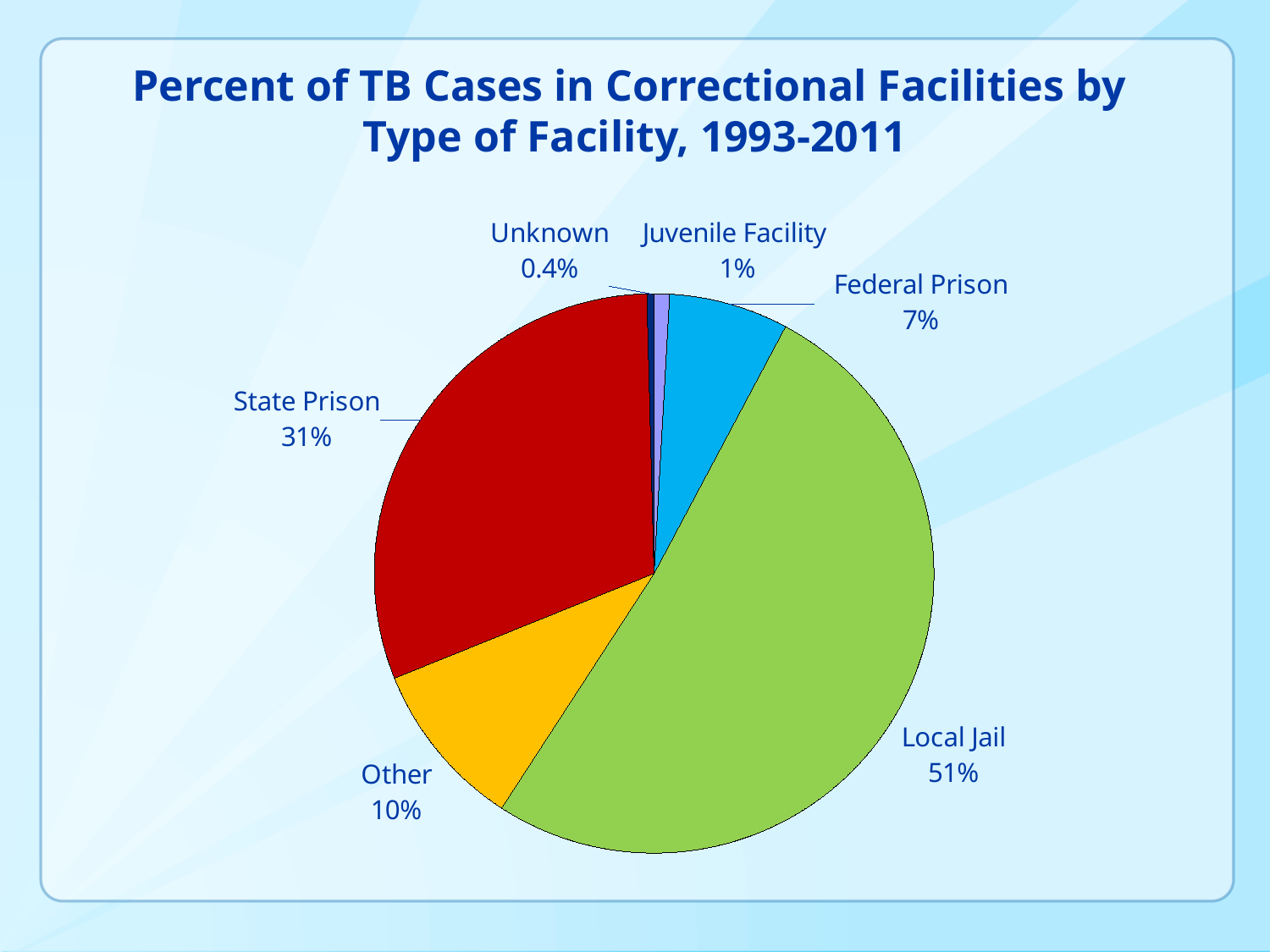
What percent of TB cases were in Federal Prisons? 7% What is the title of the chart? Percent of TB Cases in Correctional Facilities by Type of Facility, 1993-2011 What percent of TB cases had an Unknown facility type? 0.4% What percent of TB cases were in State Prisons? 31% Which has a larger share of TB cases, Federal Prison or Other? Other What is the difference in percentage points between Local Jail and State Prison? 20 Which type of facility accounts for the largest share of TB cases? Local Jail Which type of facility accounts for the smallest share of TB cases? Unknown What percent of TB cases in correctional facilities were in Local Jails? 51% What percent of TB cases were in Juvenile Facilities? 1% What type of chart is shown on the slide? pie chart How many slices does the pie chart have? 6